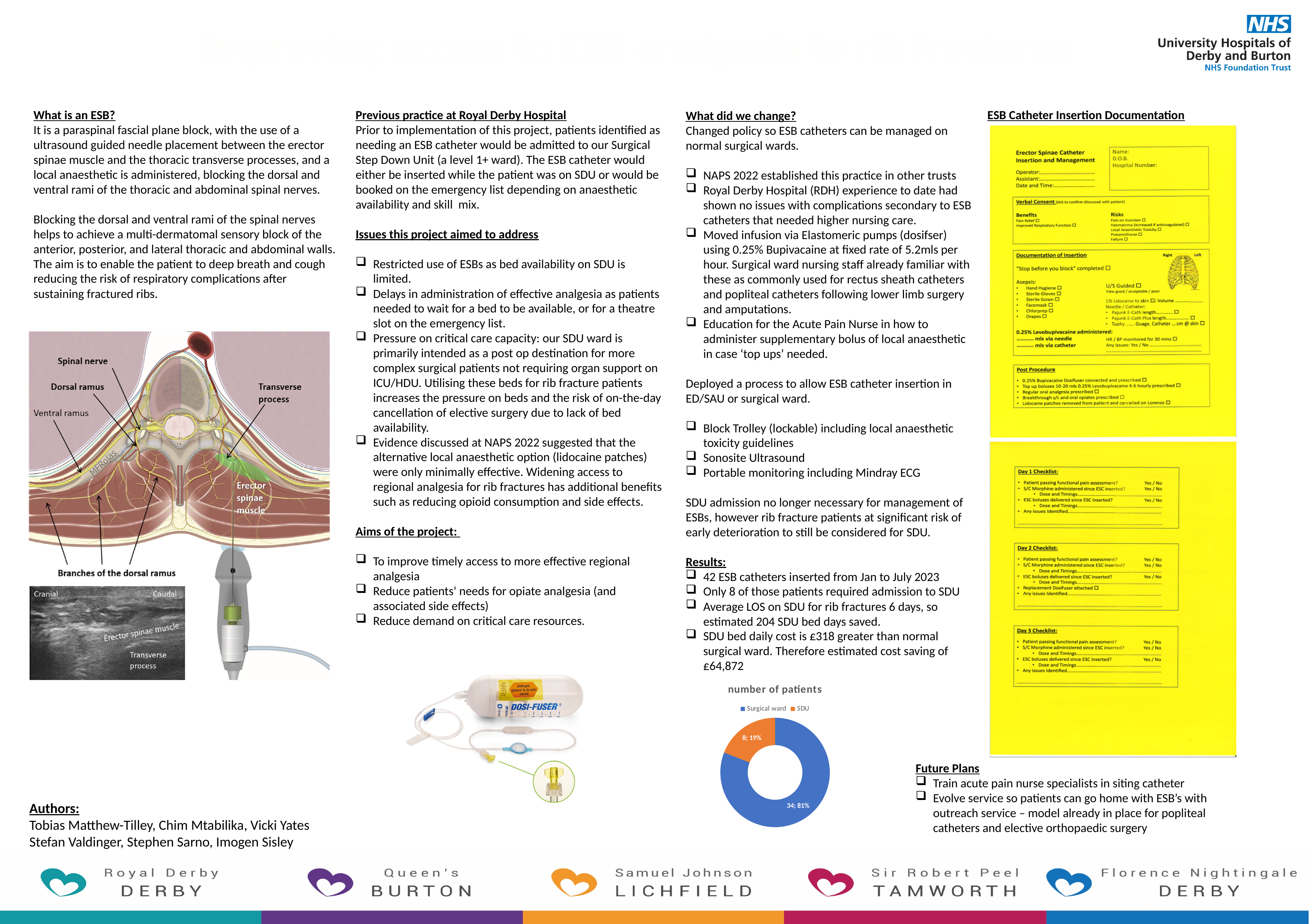
In the "number of patients" chart, what is the difference between the Surgical ward and SDU patient counts? 26 In the "number of patients" chart, how many patients are in the SDU category? 8 How many categories does the "number of patients" chart show? 2 In the "number of patients" chart, what is the total number of patients across both categories? 42 Which category has the largest slice in the "number of patients" chart? Surgical ward What kind of chart is the "number of patients" chart? doughnut chart What is the title of the chart on the slide? number of patients Which two categories does the legend of the "number of patients" chart list? Surgical ward and SDU In the "number of patients" chart, how many patients are in the Surgical ward category? 34 In the "number of patients" chart, what percentage share does the Surgical ward slice have? 81% Which category has the smallest slice in the "number of patients" chart? SDU In the "number of patients" chart, what percentage share does the SDU slice have? 19%